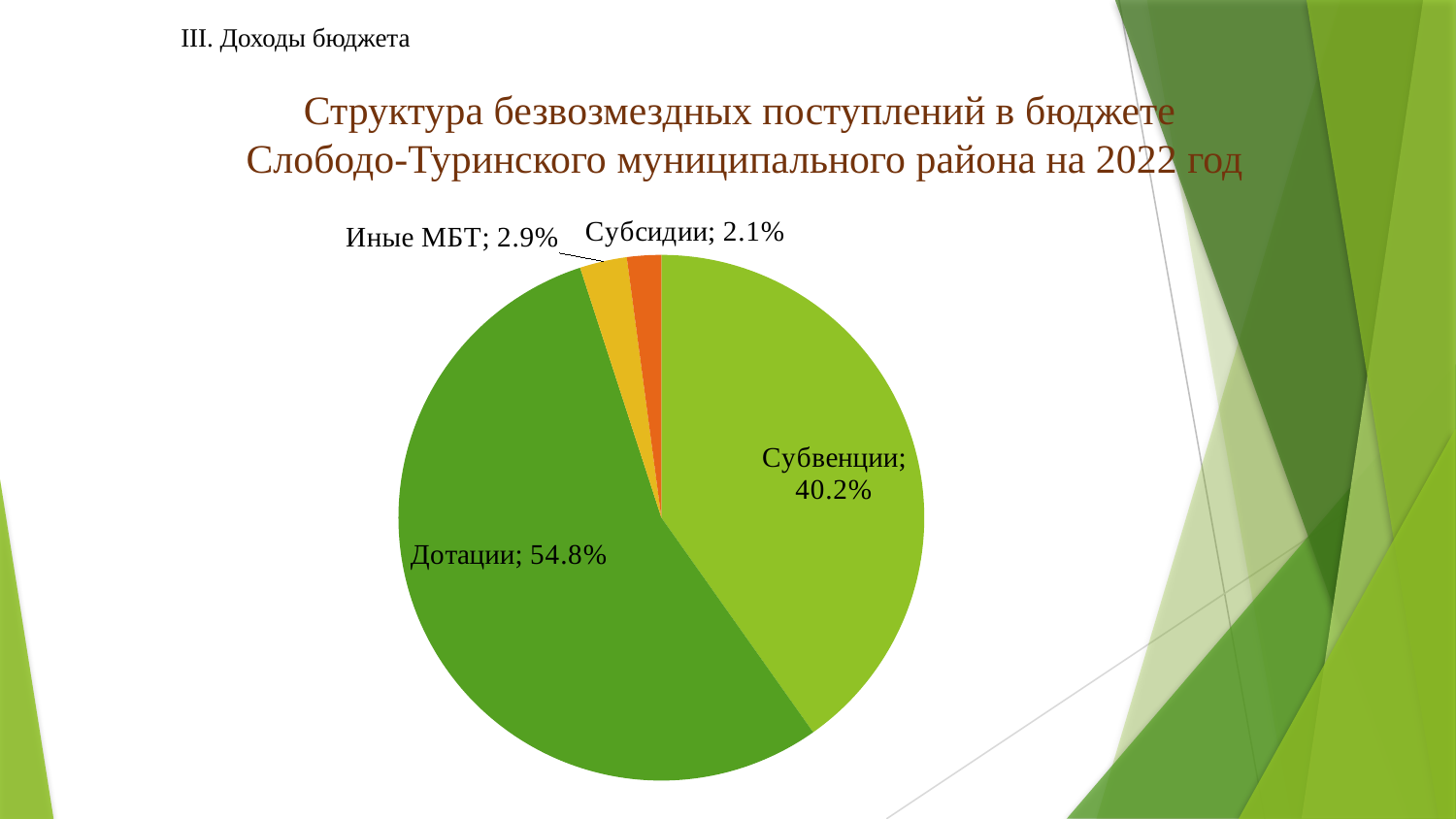
What is the combined share of Иные МБТ and Субсидии? 5.0% What is the difference in percentage points between Дотации and Субвенции? 14.6 What share of the pie does Иные МБТ have? 2.9% What share of the pie does Субвенции have? 40.2% Which category has the largest slice of the pie? Дотации Which is larger, the share for Иные МБТ or the share for Субсидии? Иные МБТ Which category has the smallest slice of the pie? Субсидии What share of the pie does Дотации have? 54.8% What share of the pie does Субсидии have? 2.1% What year does the chart title refer to? 2022 How many slices does the pie chart have? 4 What kind of chart is shown on the slide? pie chart